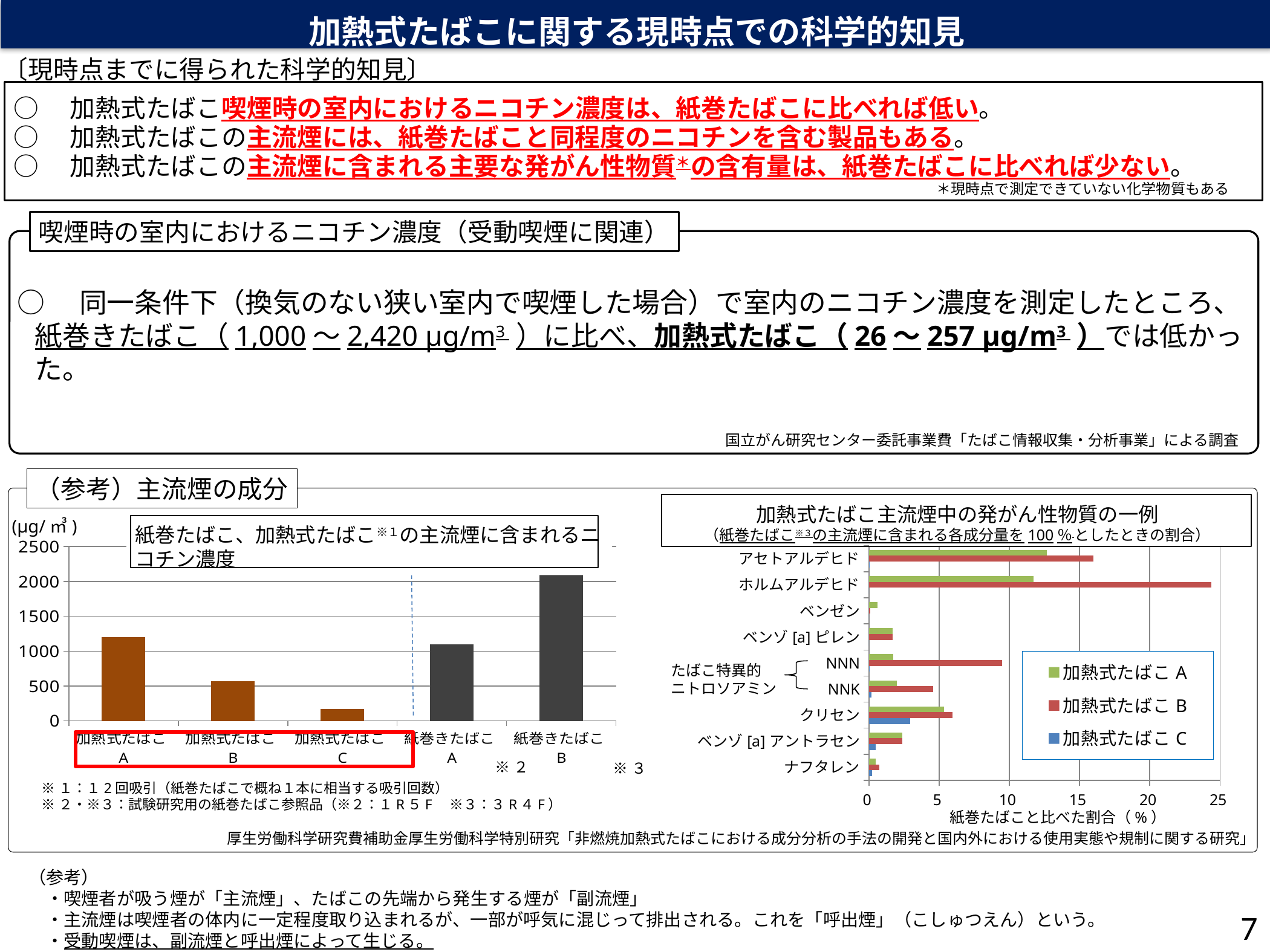
In the left chart (ニコチン濃度), how many categories are plotted on the x axis? 5 In the left chart (ニコチン濃度), which category has the highest value? 紙巻きたばこ B In the left chart (ニコチン濃度), is the value for 加熱式たばこ C greater or less than 500? less In the right chart (加熱式たばこ主流煙中の発がん性物質の一例), for which substance does 加熱式たばこ B have its highest value? ホルムアルデヒド In the left chart (ニコチン濃度), is the value for 加熱式たばこ A greater or less than 1000? greater In the left chart (ニコチン濃度), which category has the lowest value? 加熱式たばこ C In the left chart (ニコチン濃度), is the value for 紙巻きたばこ B greater or less than 2000? greater What kind of chart is the left chart showing nicotine concentration in mainstream smoke (紙巻たばこ、加熱式たばこの主流煙に含まれるニコチン濃度)? bar chart In the left chart (ニコチン濃度), which is larger, the value for 加熱式たばこ A or 加熱式たばこ B? 加熱式たばこ A In the right chart (加熱式たばこ主流煙中の発がん性物質の一例), how many series does the legend list? 3 In the right chart (加熱式たばこ主流煙中の発がん性物質の一例), how many substances are listed on the vertical axis? 9